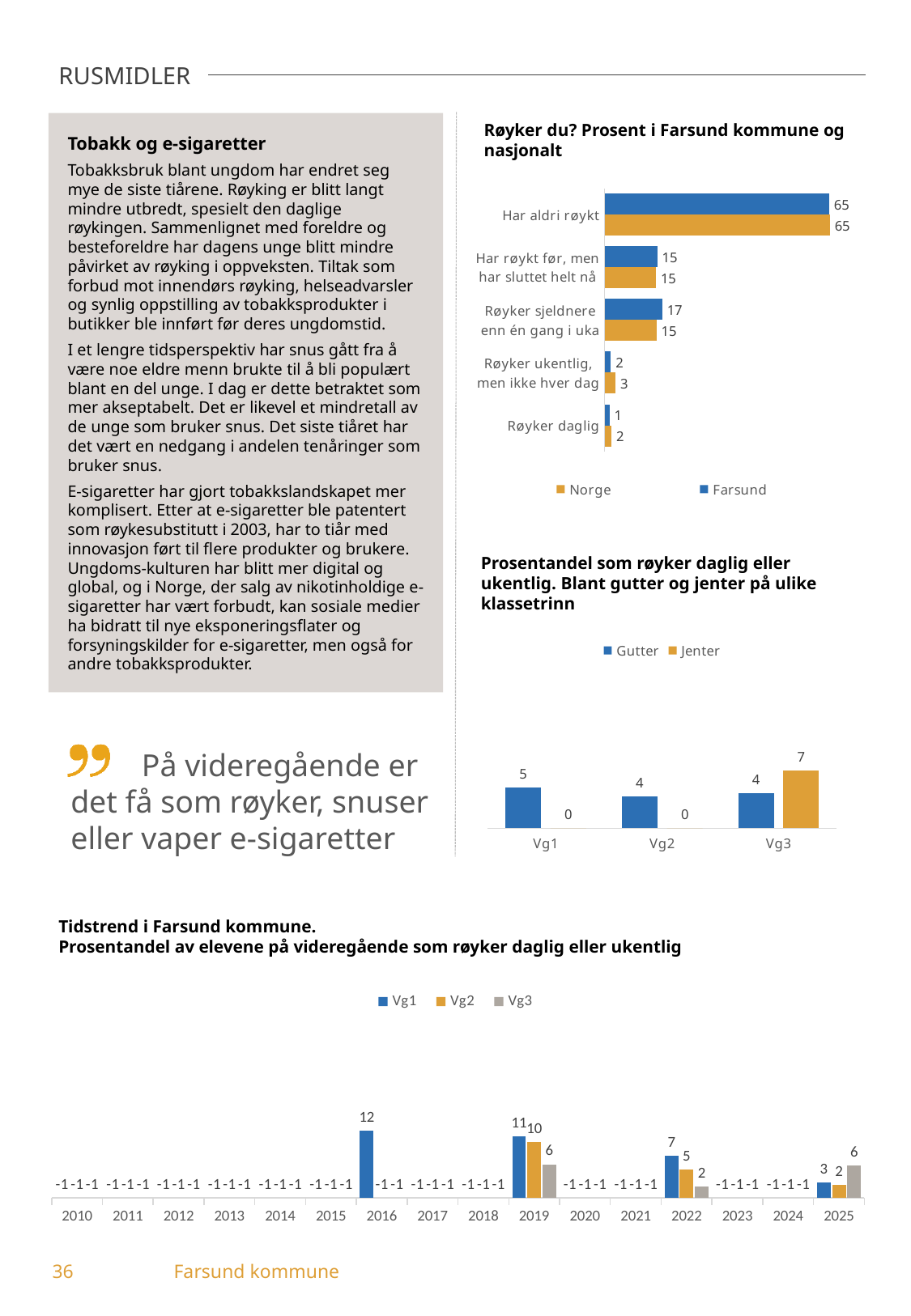
In the chart 'Røyker du? Prosent i Farsund kommune og nasjonalt', what is the difference between Farsund and Norge for 'Røyker sjeldnere enn én gang i uka'? 2 In the chart 'Tidstrend i Farsund kommune', which series has the highest value in 2025? Vg3 In the chart 'Prosentandel som røyker daglig eller ukentlig', which is larger at Vg1, Gutter or Jenter? Gutter In the chart 'Røyker du? Prosent i Farsund kommune og nasjonalt', what is the value for Farsund for 'Har aldri røykt'? 65 In the chart 'Tidstrend i Farsund kommune', what is the value for Vg1 in 2016? 12 In the chart 'Røyker du? Prosent i Farsund kommune og nasjonalt', which category has the highest value for Farsund? Har aldri røykt In the chart 'Røyker du? Prosent i Farsund kommune og nasjonalt', what is the value for Norge for 'Røyker sjeldnere enn én gang i uka'? 15 In the chart 'Prosentandel som røyker daglig eller ukentlig', how many class levels are shown on the x axis? 3 In the chart 'Tidstrend i Farsund kommune', what is the difference between Vg1 and Vg3 in 2019? 5 In the chart 'Røyker du? Prosent i Farsund kommune og nasjonalt', how many series does the legend list? 2 What kind of chart is 'Tidstrend i Farsund kommune'? Bar chart In the chart 'Prosentandel som røyker daglig eller ukentlig', what is the value for Jenter at Vg3? 7